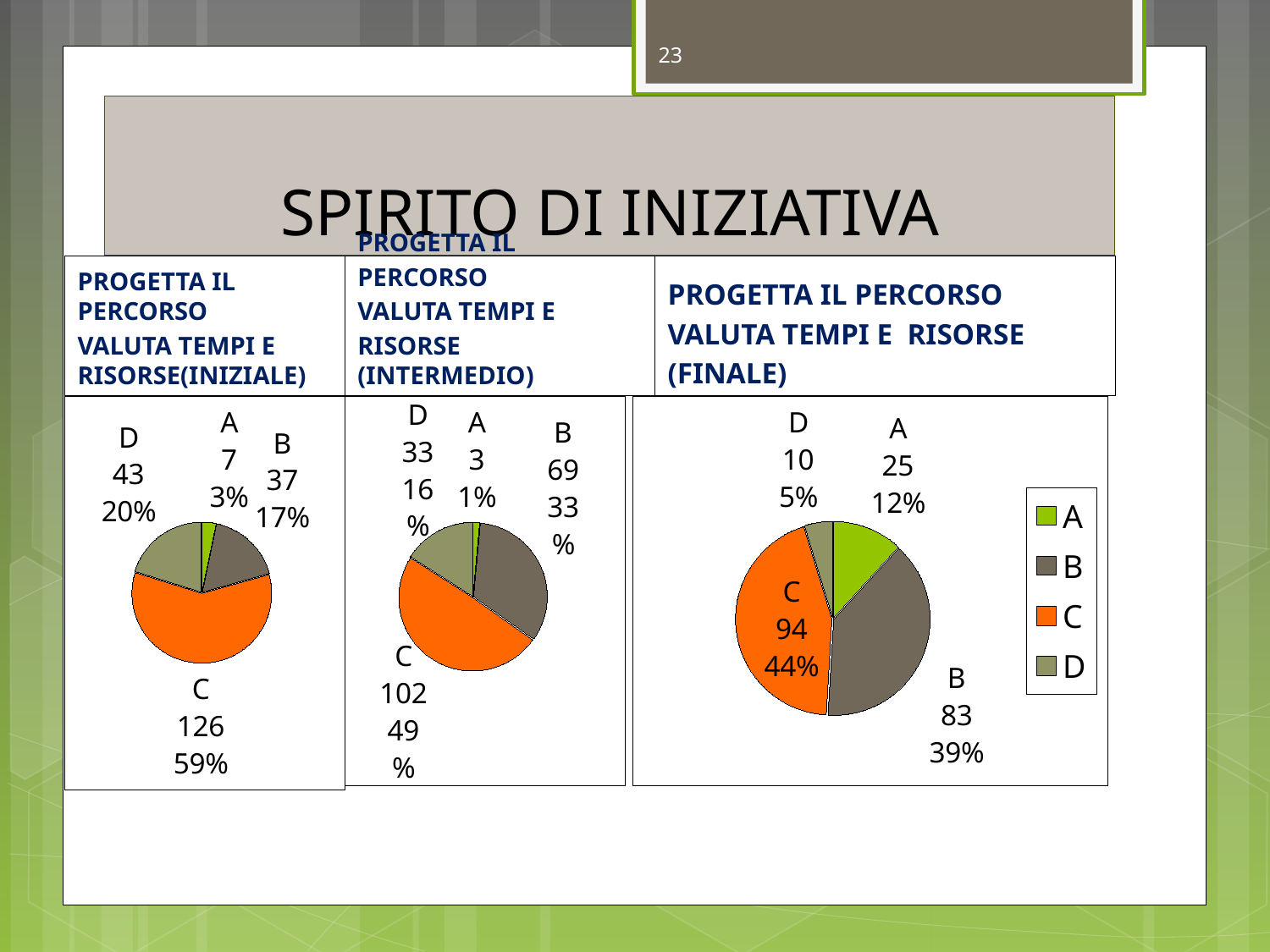
In the INIZIALE pie chart, which is larger, the value for B or the value for D? D What type of chart is used in the FINALE panel? Pie chart In the INTERMEDIO pie chart, which category has the smallest slice? A In the FINALE pie chart, what is the value for category A? 25 In the INIZIALE pie chart, what percentage share does category D have? 20% How many categories does the INTERMEDIO pie chart show? 4 In the FINALE pie chart, which category has the largest slice? C In the FINALE pie chart, what percentage share does category D have? 5% How many entries does the legend next to the FINALE chart list? 4 In the FINALE pie chart, what is the difference between the values for C and B? 11 In the INIZIALE pie chart, what is the value for category C? 126 In the INTERMEDIO pie chart, what is the value for category B? 69